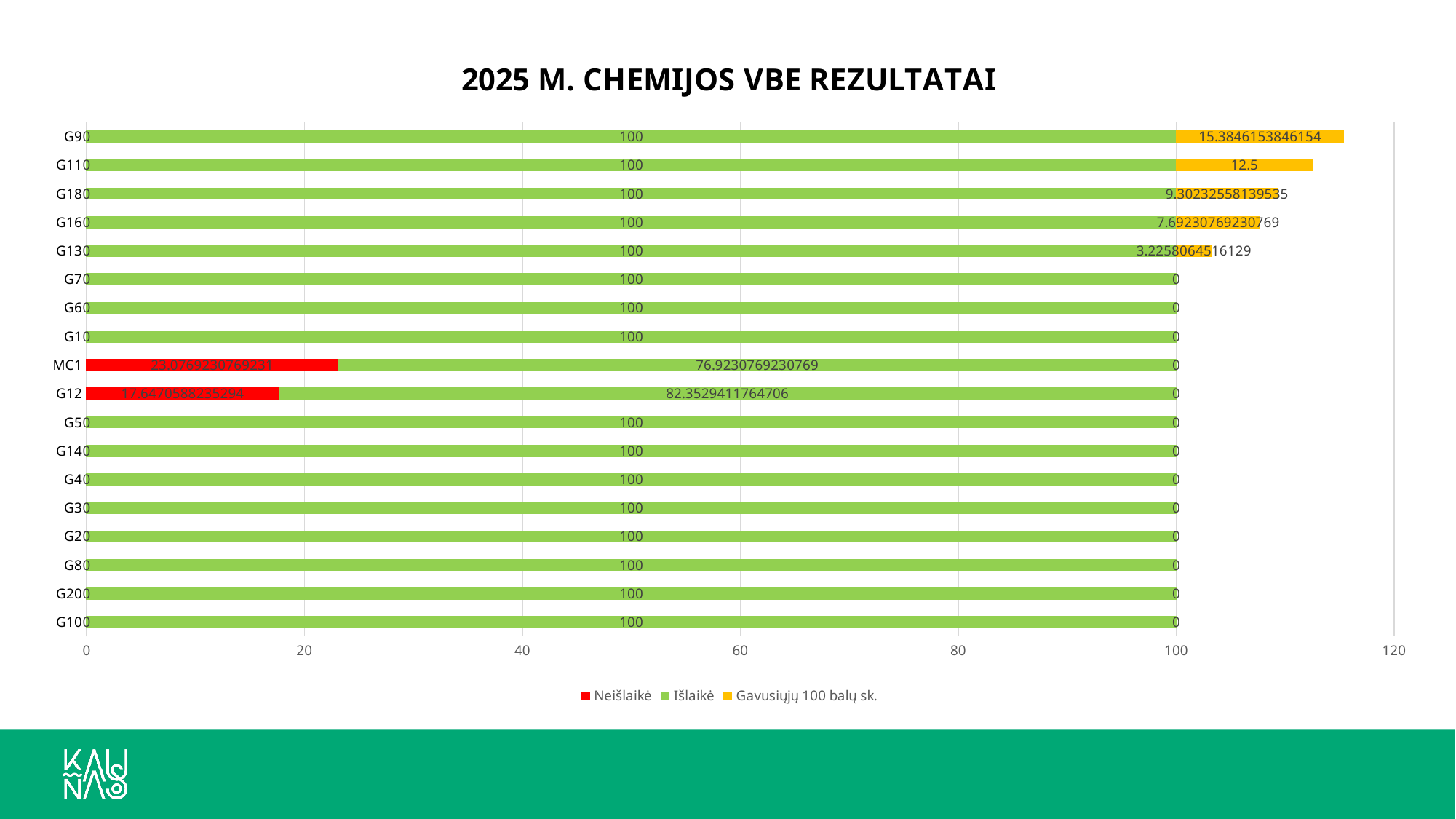
Which category has the lowest Išlaikė value? MC1 What is the Neišlaikė value for G12? 17.6470588235294 What is the title of the chart? 2025 M. CHEMIJOS VBE REZULTATAI Which category has the highest Gavusiųjų 100 balų sk. value? G90 What is the Išlaikė value for MC1? 76.9230769230769 How many categories are shown on the vertical axis? 18 Which is larger, the Neišlaikė value for MC1 or for G12? MC1 How many series does the legend list? 3 What is the Gavusiųjų 100 balų sk. value for G110? 12.5 What is the difference between the Gavusiųjų 100 balų sk. values for G110 and G130? 9.2741935483871 What is the total of the stacked bar for G110? 112.5 What type of chart is shown on the slide? bar chart